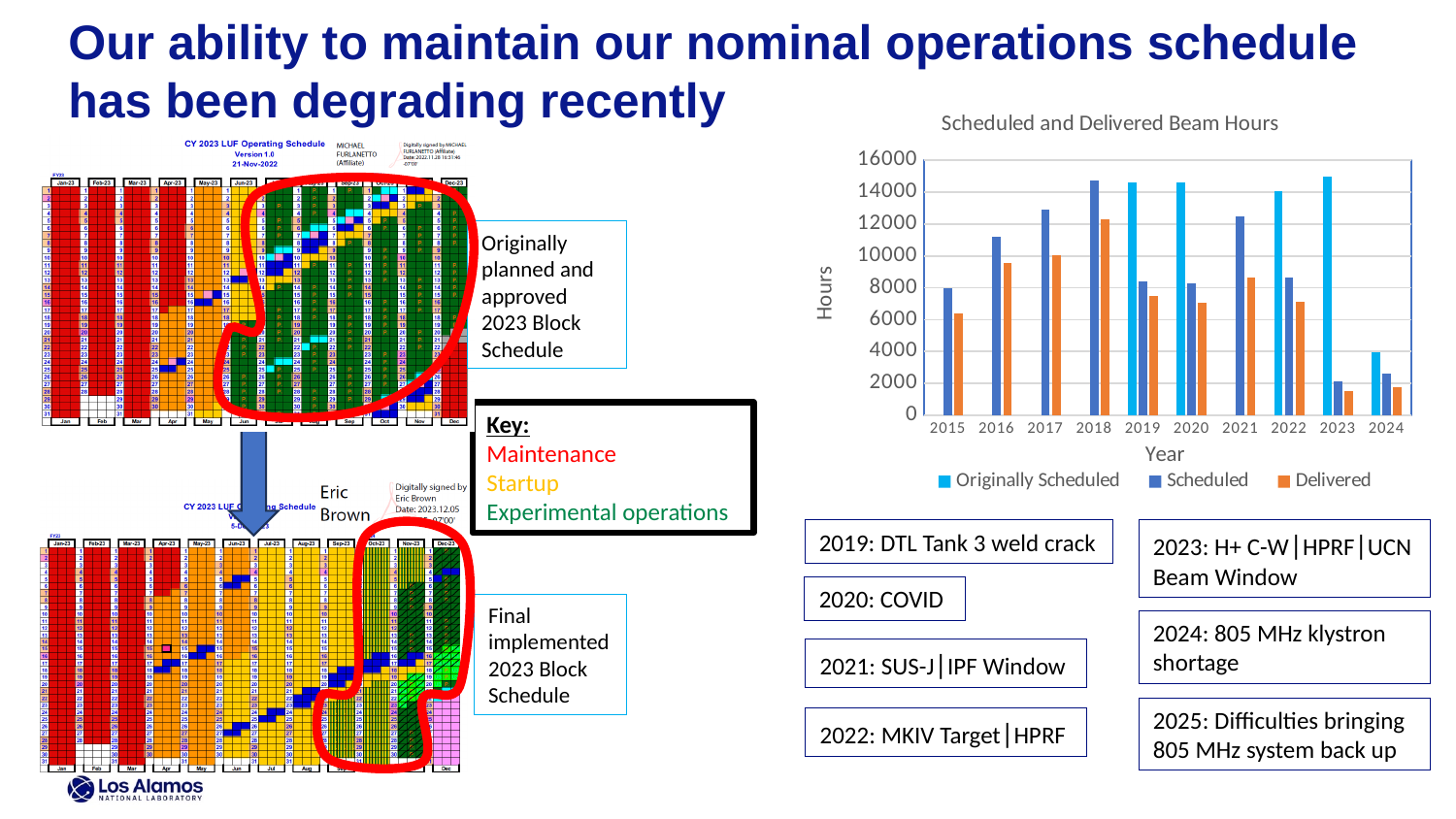
In the 'Scheduled and Delivered Beam Hours' chart, which year has the highest Delivered value? 2018 What is the label on the x axis of the 'Scheduled and Delivered Beam Hours' chart? Year In the 'Scheduled and Delivered Beam Hours' chart, which is larger for 2016: the Scheduled value or the Delivered value? Scheduled In the 'Scheduled and Delivered Beam Hours' chart, is the Scheduled value for 2016 greater or less than 10000? greater In the 'Scheduled and Delivered Beam Hours' chart, is the Delivered value for 2023 greater or less than 2000? less In the 'Scheduled and Delivered Beam Hours' chart, is the Delivered value for 2019 greater or less than 8000? less In the 'Scheduled and Delivered Beam Hours' chart, which year has the lowest Delivered value? 2023 What kind of chart is the 'Scheduled and Delivered Beam Hours' chart? bar chart How many years are shown on the x axis of the 'Scheduled and Delivered Beam Hours' chart? 10 How many series does the legend of the 'Scheduled and Delivered Beam Hours' chart list? 3